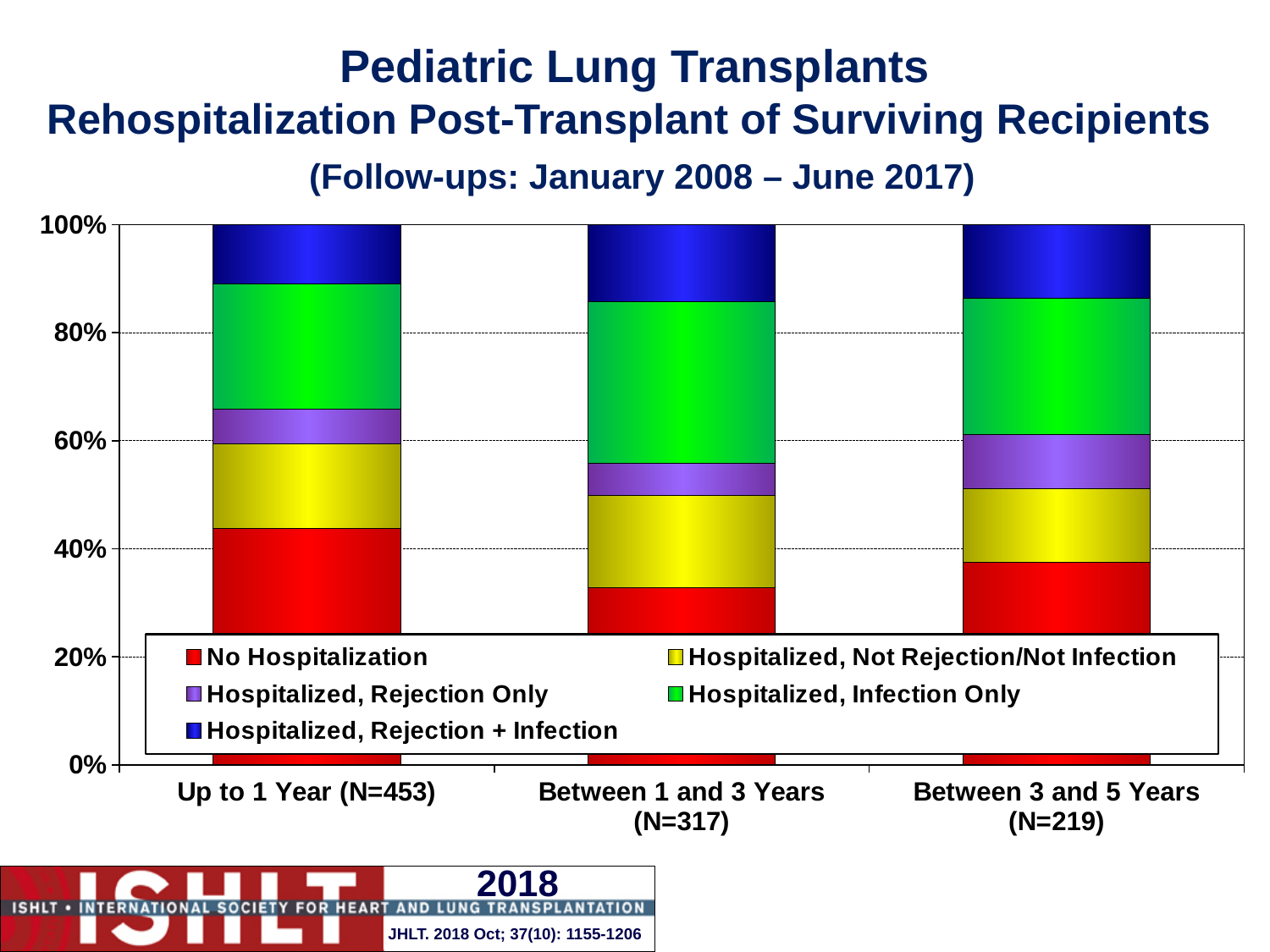
What is the total of each stacked bar? 100% Which follow-up category has the largest No Hospitalization share? Up to 1 Year (N=453) Is the No Hospitalization share for Between 1 and 3 Years greater or less than 40%? less Is the No Hospitalization share for Up to 1 Year greater or less than 40%? greater Which colour represents No Hospitalization in the legend? Red Which follow-up category has the smallest No Hospitalization share? Between 1 and 3 Years (N=317) Is the Hospitalized, Infection Only segment larger for Up to 1 Year or for Between 1 and 3 Years? Between 1 and 3 Years What kind of chart is shown on the slide? Stacked bar chart How many follow-up time categories are shown on the x axis? 3 How many series does the legend list? 5 What is the N for the Up to 1 Year category? 453